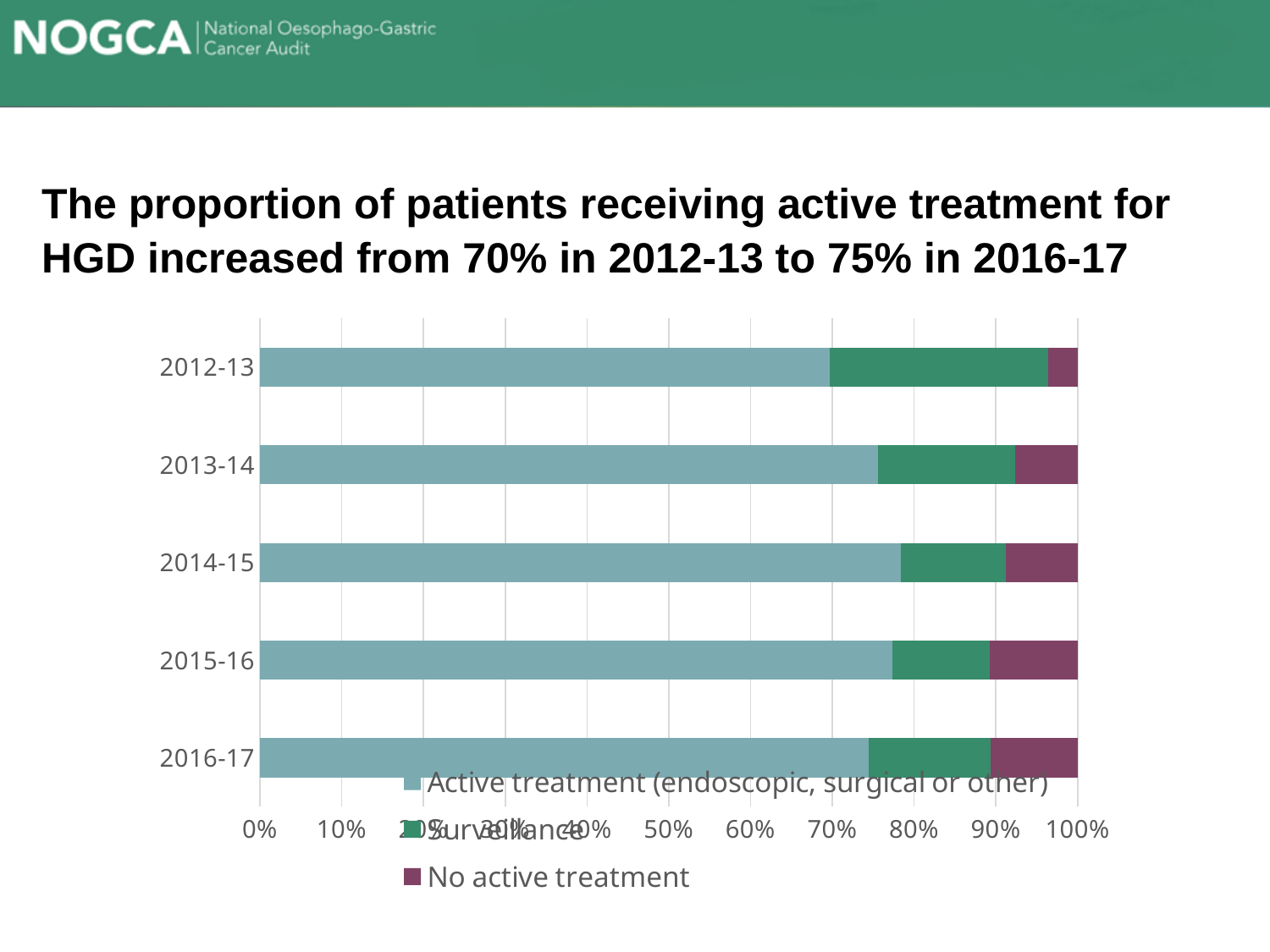
Is the active treatment share for 2014-15 greater or less than 70%? greater Is the active treatment share for 2012-13 greater or less than 60%? greater Which year has the smallest share of patients receiving no active treatment? 2012-13 What is the total of each stacked bar on the chart? 100% What kind of chart is shown on the slide? Stacked bar chart What is the first series listed in the legend? Active treatment (endoscopic, surgical or other) Which year has the larger active treatment share, 2012-13 or 2016-17? 2016-17 Which legend entry is shown in the dark purple colour? No active treatment How many series does the legend list? 3 How many years (categories) are plotted on the chart? 5 Which year has the smallest share of patients receiving active treatment? 2012-13 Is the no active treatment share for 2012-13 greater or less than 10%? less